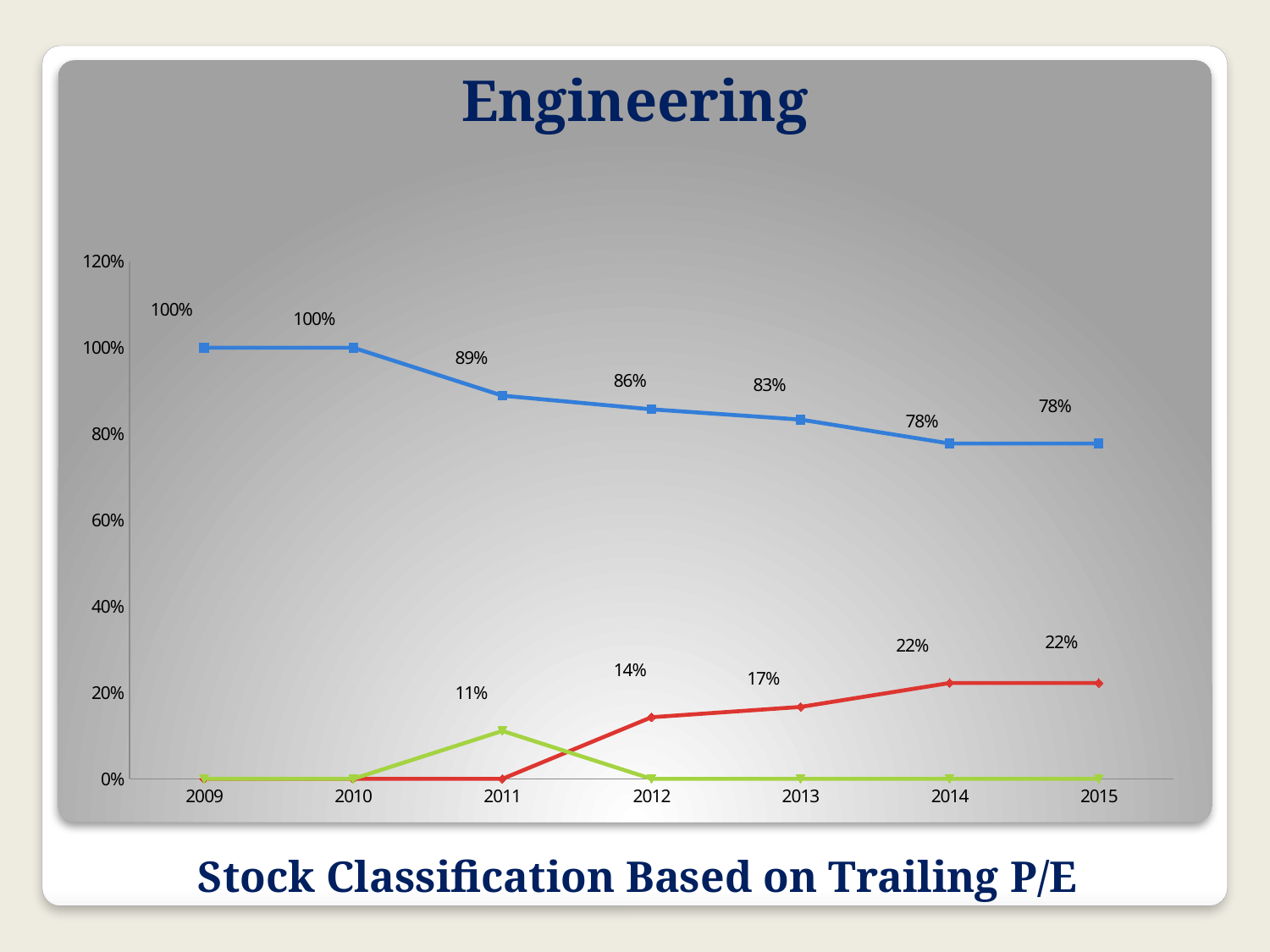
What is the title of the chart? Engineering What is the value of the red line in 2012? 14% In which year does the blue line reach its lowest labelled value? 2014 and 2015 What is the value of the green line in 2011? 11% How many years are shown on the x axis? 7 What is the value of the blue line in 2013? 83% What is the difference between the blue line's value in 2009 and its value in 2015? 22% What is the value of the red line in 2014? 22% What is the value of the blue line in 2011? 89% What kind of chart is shown on the slide? line chart Does the blue line rise or fall from 2009 to 2015? fall Which is larger in 2013, the blue line's value or the red line's value? the blue line